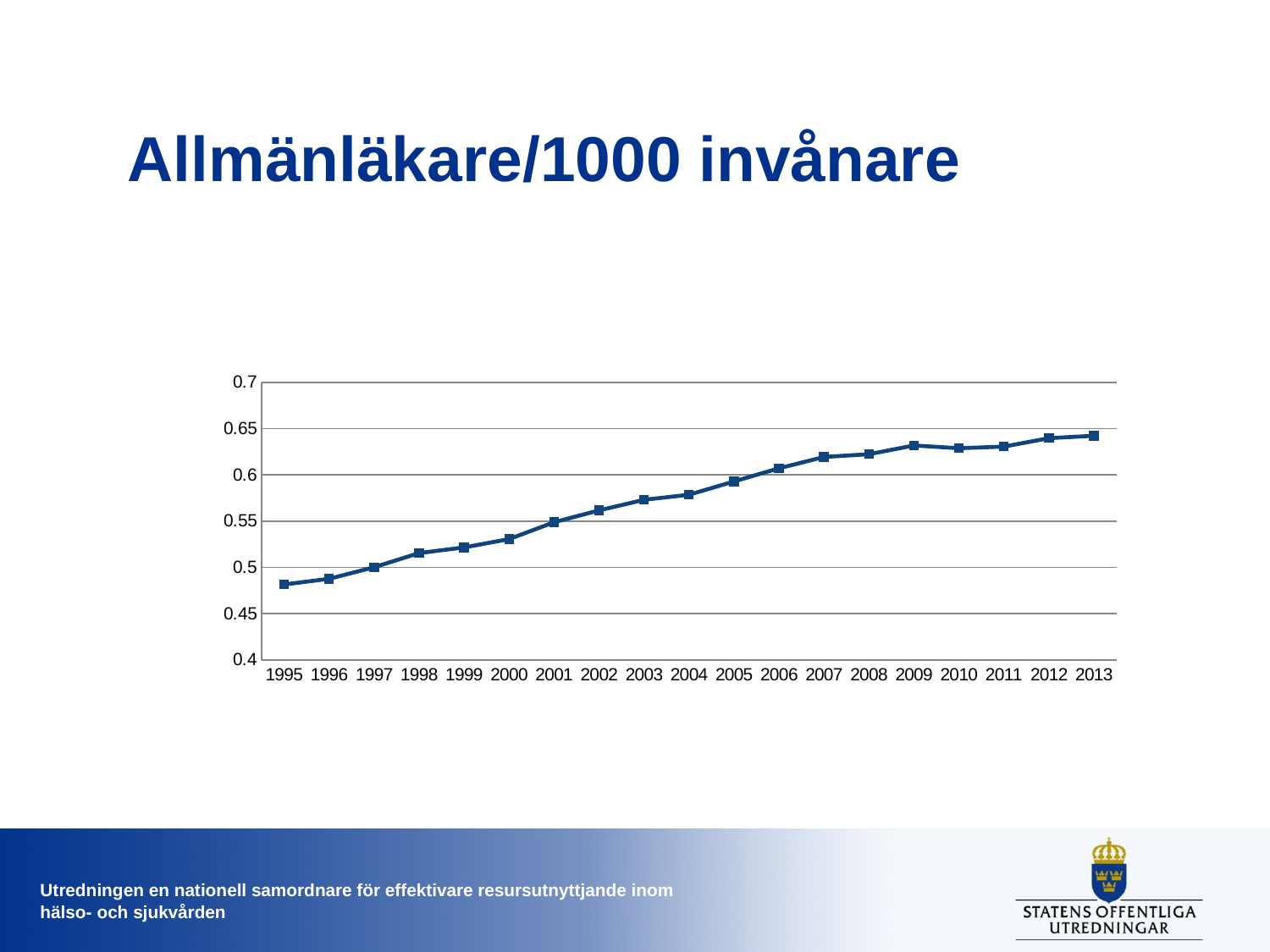
Is the value for 1995 greater or less than 0.5? less What is the title of the slide containing the chart? Allmänläkare/1000 invånare Which year has the highest value in the chart? 2013 Is the value for 2006 greater or less than 0.6? greater Is the value for 2004 greater or less than 0.6? less What is the lowest value shown on the y axis of the chart? 0.4 Which year has the lowest value in the chart? 1995 Which year has the larger value, 2003 or 2007? 2007 Do the values in the chart generally rise or fall from 1995 to 2013? rise What kind of chart is shown on the slide? line chart How many years are plotted on the x axis of the chart? 19